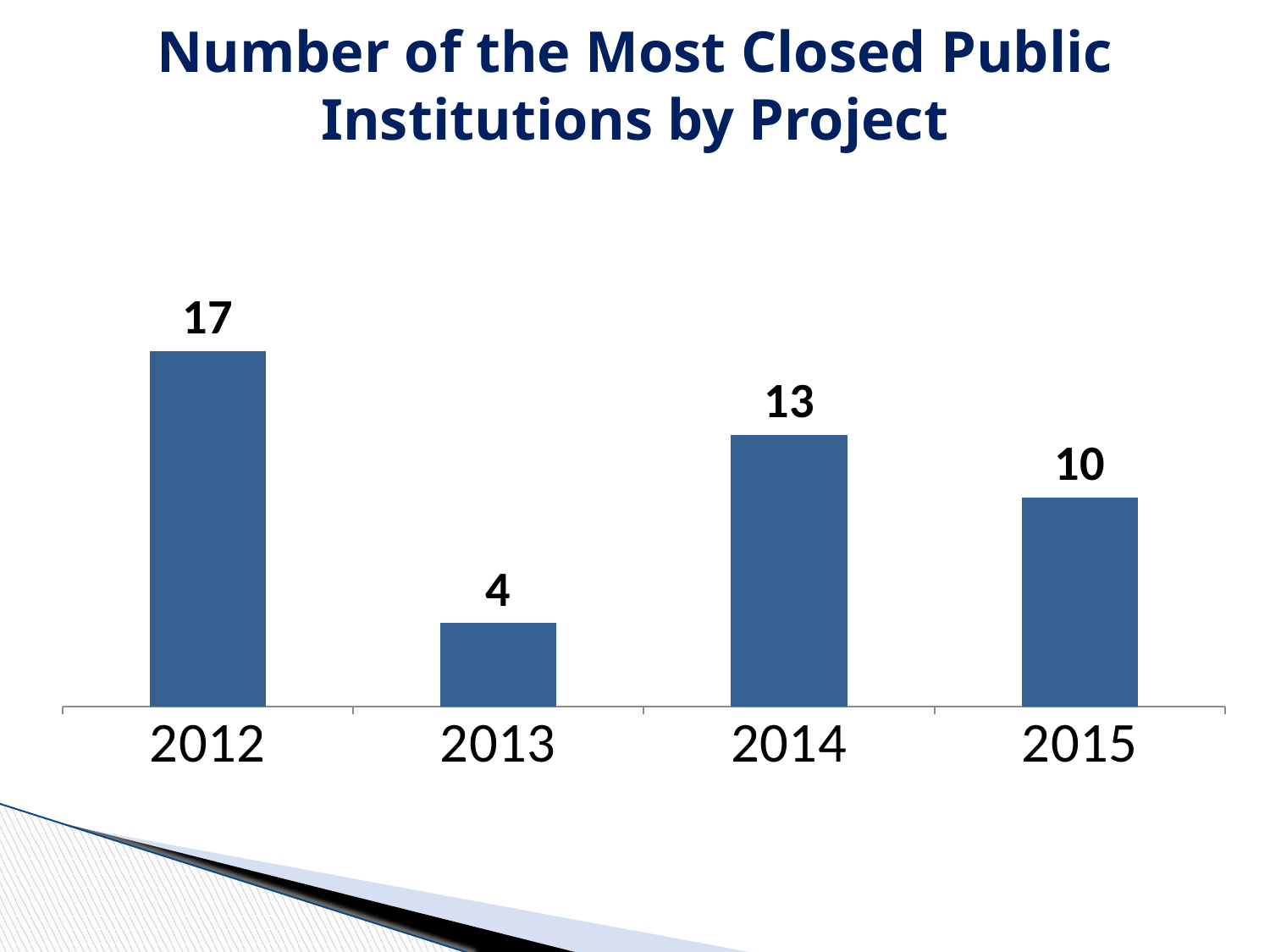
Which year has the highest value? 2012 What is the value for 2015? 10 What is the title of the chart? Number of the Most Closed Public Institutions by Project What is the value for 2013? 4 What is the difference between the values for 2012 and 2013? 13 What kind of chart is shown on the slide? bar chart What is the value for 2014? 13 What is the value for 2012? 17 How many years are shown on the x axis? 4 Which is larger, the value for 2014 or the value for 2015? 2014 What is the difference between the values for 2014 and 2015? 3 Which year has the lowest value? 2013